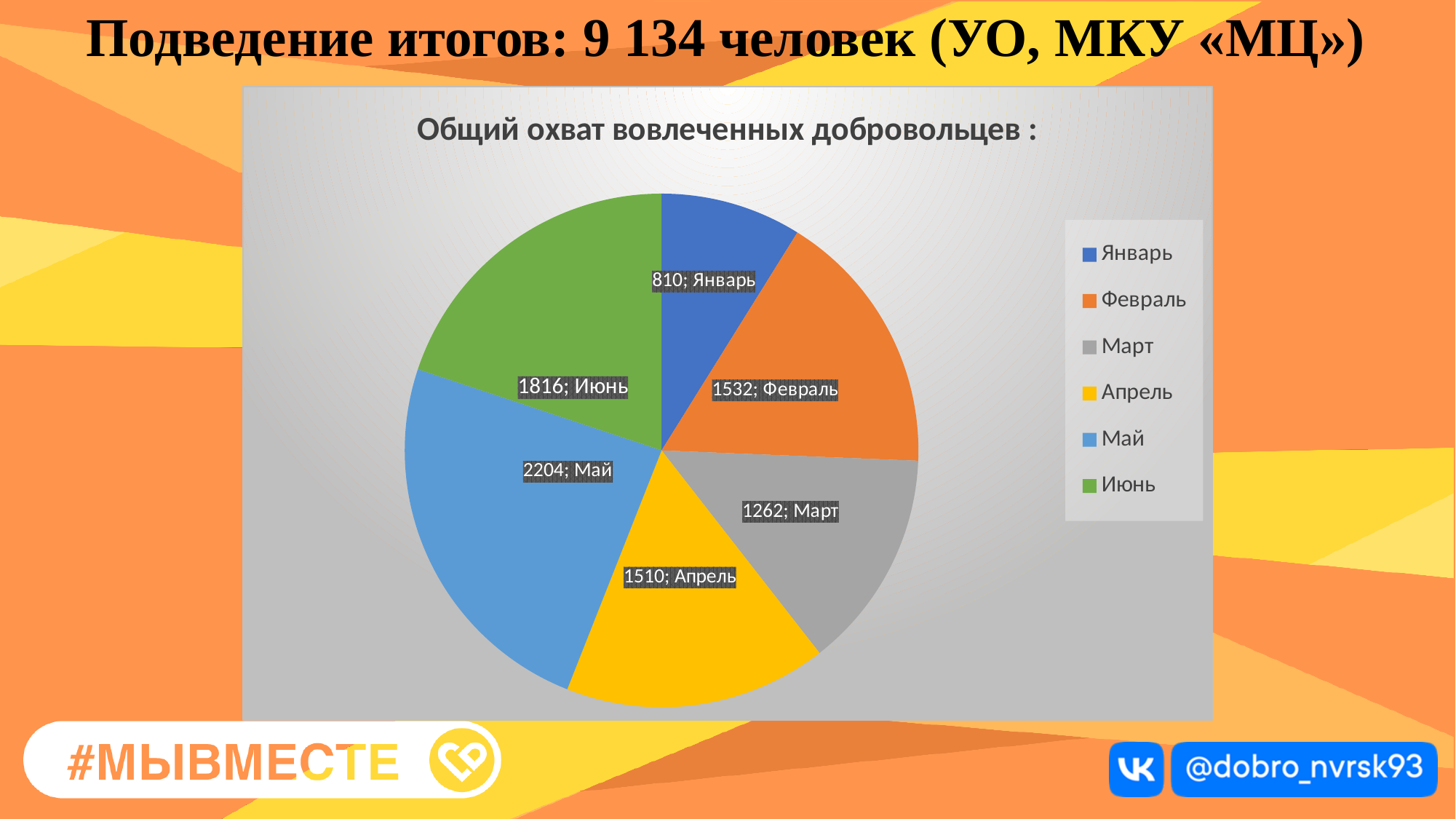
Which is larger, the value for Июнь or the value for Февраль? Июнь What is the title of the chart? Общий охват вовлеченных добровольцев : What is the value for Январь in the pie chart? 810 What share of the pie does Май represent? 24.1% What type of chart is shown on the slide? pie chart What is the difference between the values for Май and Январь? 1394 How many slices does the pie chart have? 6 What is the value for Май in the pie chart? 2204 Which month has the smallest slice in the pie chart? Январь What is the value for Апрель in the pie chart? 1510 Which month has the largest slice in the pie chart? Май What is the difference between the values for Июнь and Март? 554